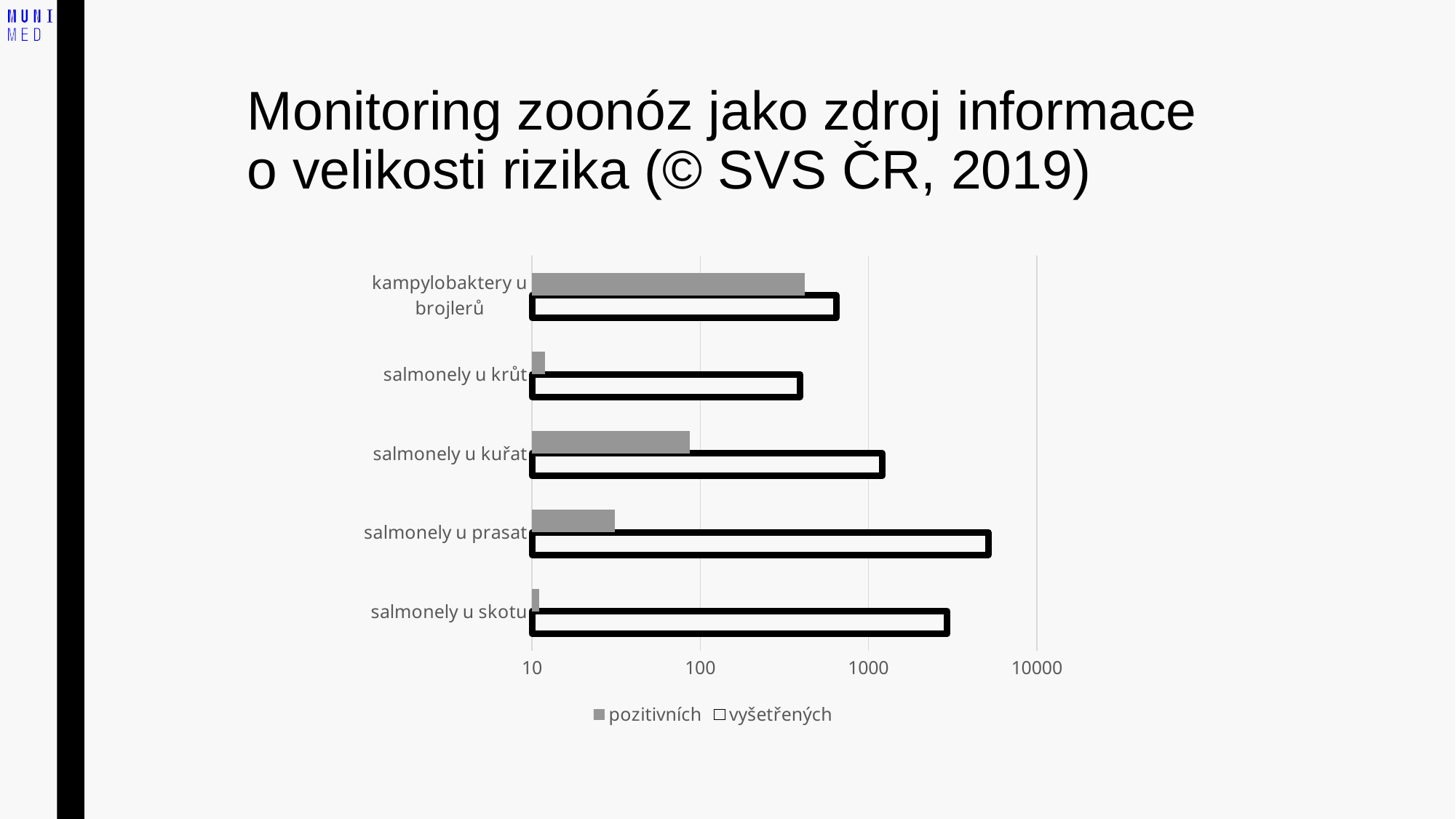
How many series does the legend list? 2 What are the two series named in the legend? pozitivních and vyšetřených Is the value for pozitivních for salmonely u kuřat greater or less than 100? less Is the value for pozitivních for kampylobaktery u brojlerů greater or less than 100? greater Which category has the highest value for pozitivních? kampylobaktery u brojlerů Is the value for vyšetřených for salmonely u prasat greater or less than 1000? greater What kind of chart is shown on the slide? bar chart How many categories are shown on the chart? 5 Which category has the highest value for vyšetřených? salmonely u prasat Which is larger: the vyšetřených value for salmonely u skotu or for salmonely u kuřat? salmonely u skotu Which is larger: the pozitivních value for salmonely u prasat or for salmonely u kuřat? salmonely u kuřat